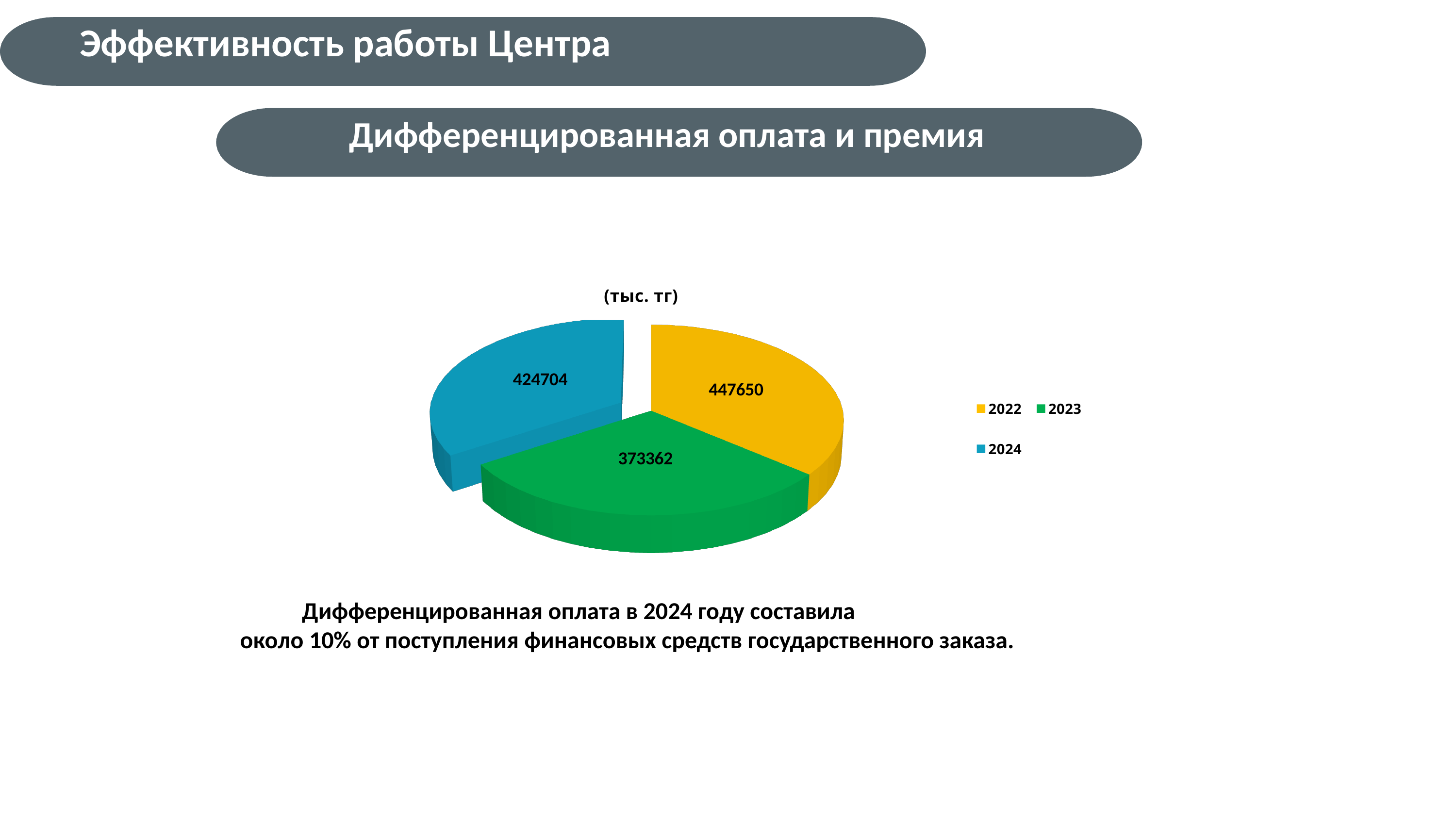
What kind of chart is shown on the slide? Pie chart What is the value for 2022 in the pie chart? 447650 What is the total of all three slices in the pie chart? 1245716 What unit is given in the title of the pie chart? (тыс. тг) What is the difference between the values for 2024 and 2023? 51342 Which is larger, the value for 2022 or the value for 2024? 2022 Which year has the smallest slice in the pie chart? 2023 Which year has the largest slice in the pie chart? 2022 What is the value for 2024 in the pie chart? 424704 What is the difference between the values for 2022 and 2023? 74288 What is the value for 2023 in the pie chart? 373362 How many slices does the pie chart have? 3